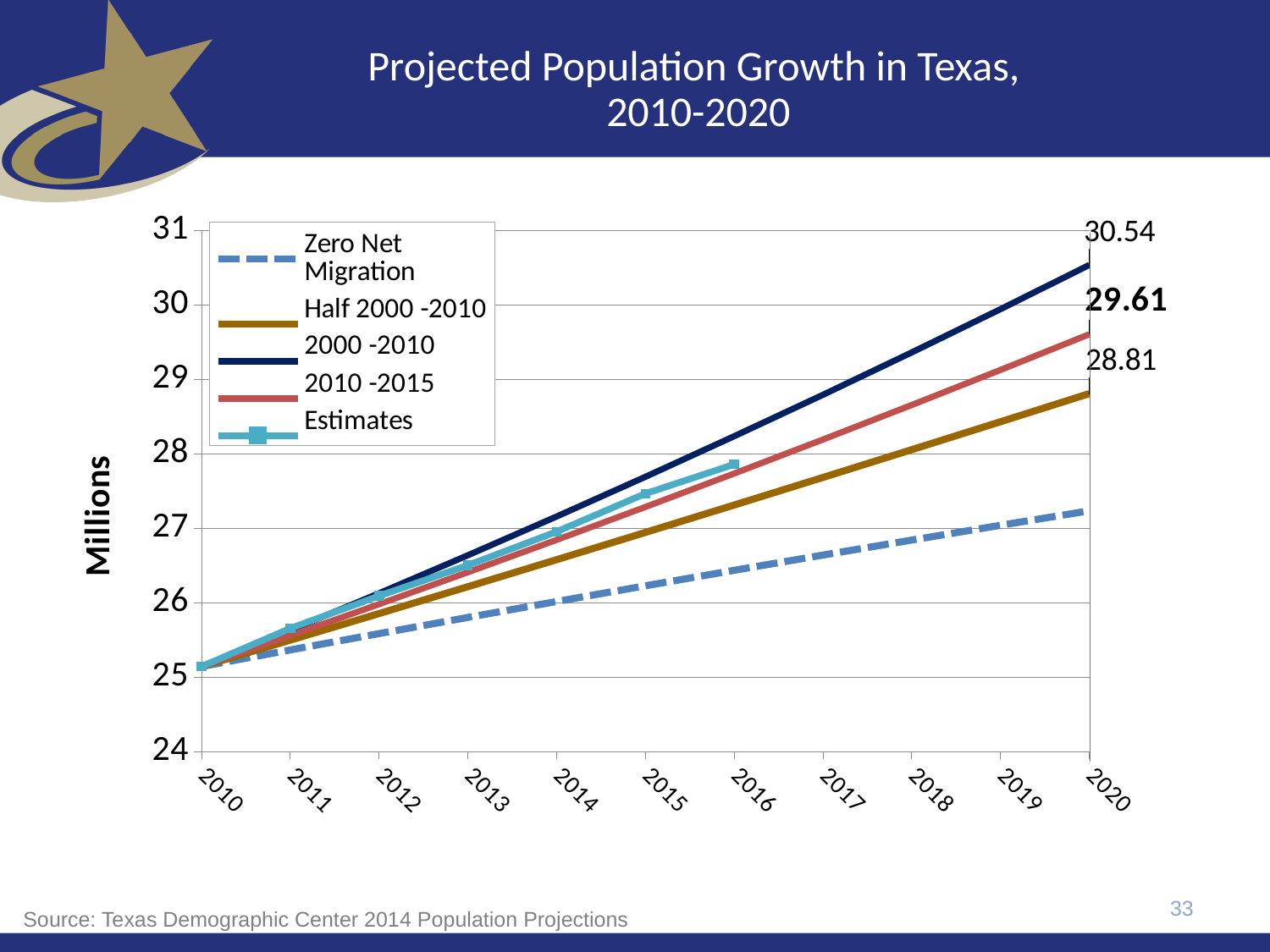
What kind of chart is shown on the slide? line chart What is the projected population (in millions) for the 2010 -2015 scenario in 2020? 29.61 Which scenario has the highest projected population in 2020? 2000 -2010 Which is larger in 2020, the 2010 -2015 projection or the Half 2000 -2010 projection? 2010 -2015 What is the projected population (in millions) for the 2000 -2010 scenario in 2020? 30.54 What is the projected population (in millions) for the Half 2000 -2010 scenario in 2020? 28.81 Which scenario has the lowest projected population in 2020? Zero Net Migration What is the label on the vertical axis? Millions Do the projected values rise or fall from 2010 to 2020? rise How many series does the legend list? 5 Is the Zero Net Migration value in 2020 greater or less than 28? less What is the difference between the 2000 -2010 and Half 2000 -2010 projections in 2020? 1.73